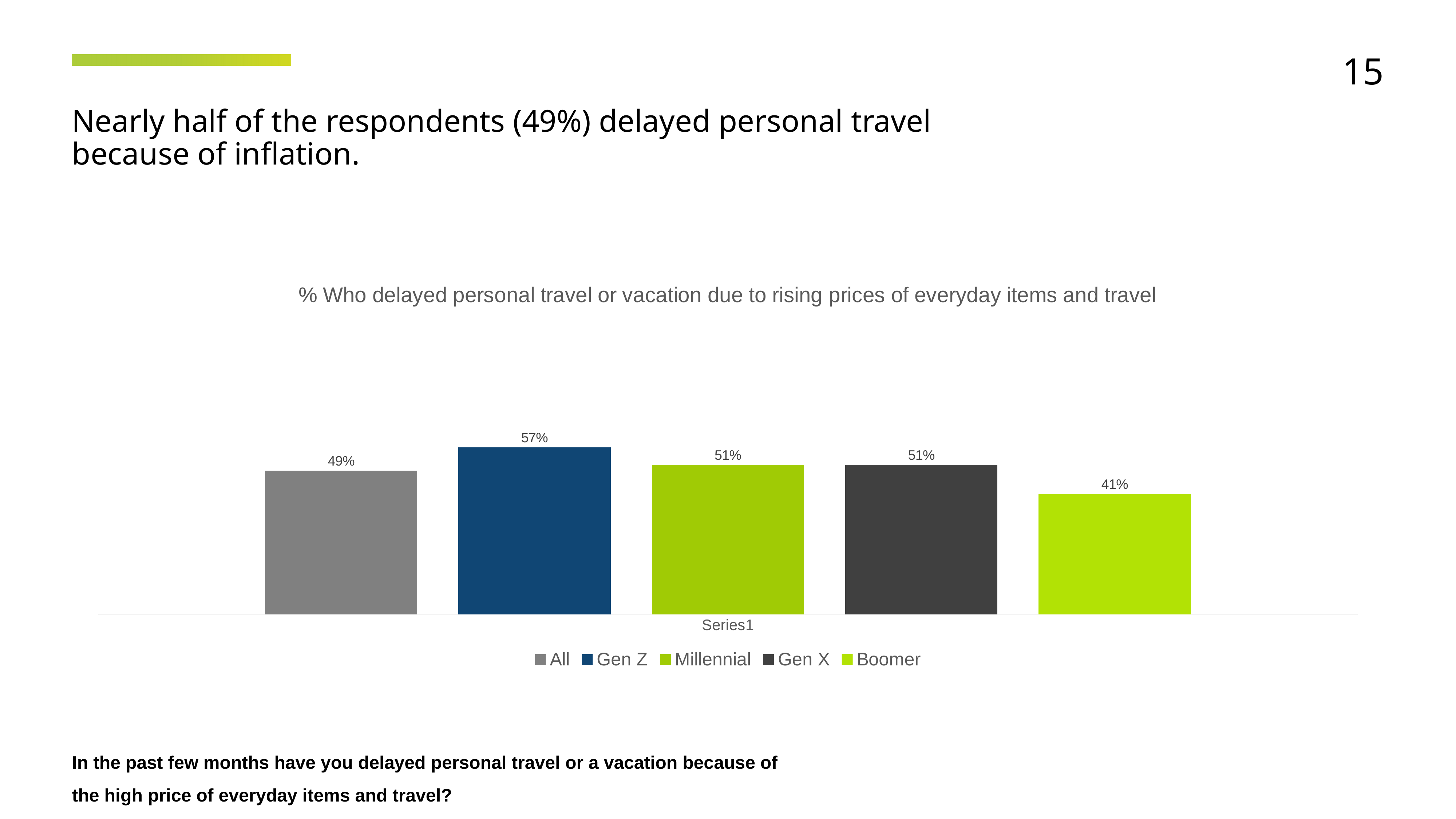
Which group has the highest value? Gen Z How many series does the legend list? 5 Which group has the lowest value? Boomer What is the value for All respondents? 49% What is the value for Millennial? 51% What is the difference between the Gen Z value and the All value? 8% What is the difference between the Gen Z value and the Boomer value? 16% What is the title of the chart? % Who delayed personal travel or vacation due to rising prices of everyday items and travel What is the value for Boomer? 41% What is the value for Gen Z? 57% What kind of chart is shown on the slide? Bar chart Which is larger, the value for Gen X or the value for Boomer? Gen X